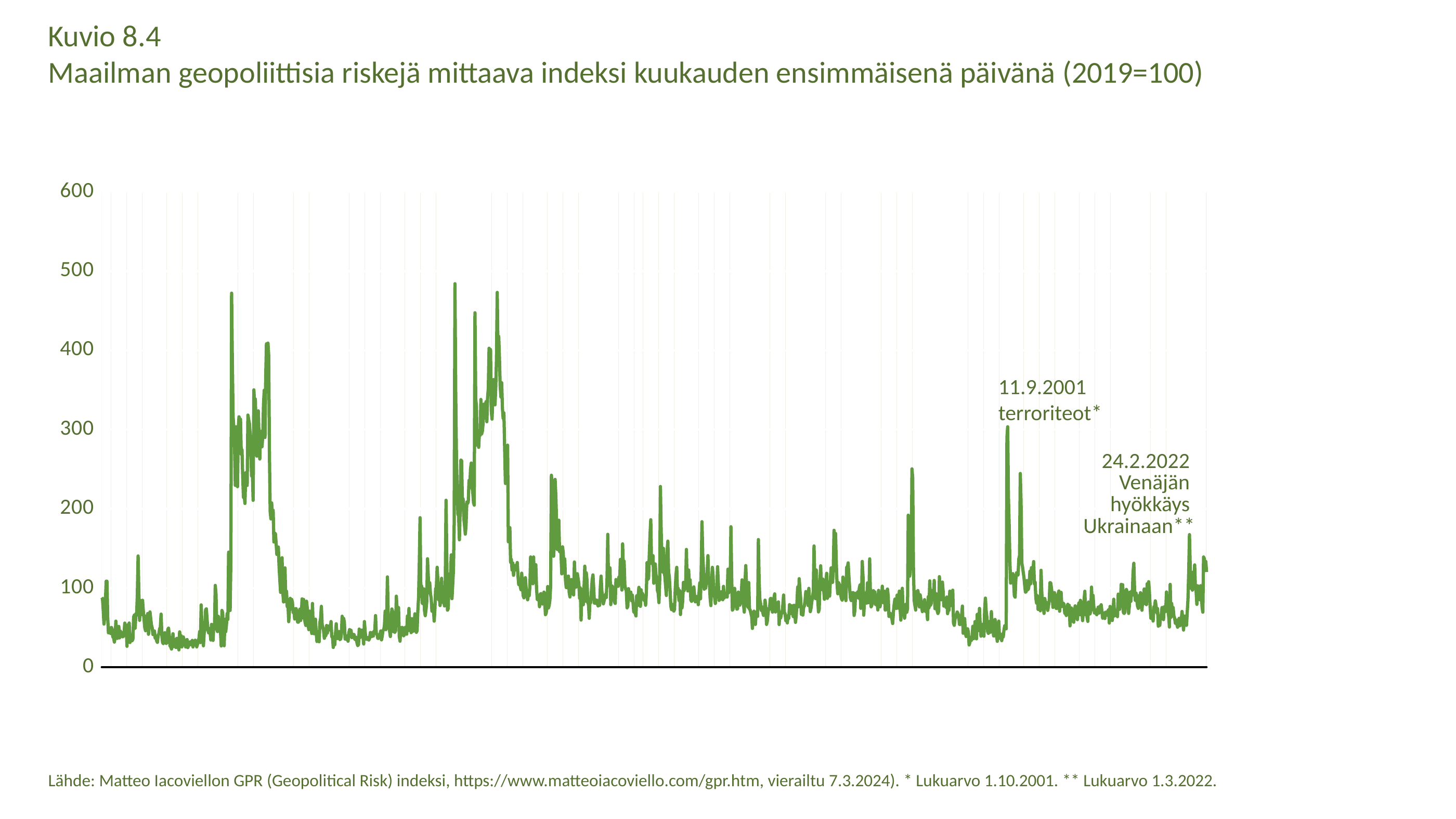
What is the highest value shown on the y axis? 600 Does the line ever rise above 400 on the y axis? yes What kind of chart is shown on the slide? line chart How many annotated events are marked on the chart? 2 What base year is the index set to 100, according to the chart title? 2019 Is the value of the index at the point annotated "24.2.2022 Venäjän hyökkäys Ukrainaan**" greater or less than 200? less What is the title of the chart? Maailman geopoliittisia riskejä mittaava indeksi kuukauden ensimmäisenä päivänä (2019=100) Is the value of the index at the point annotated "24.2.2022 Venäjän hyökkäys Ukrainaan**" greater or less than 100? greater Which annotated event has the higher index value: 11.9.2001 terroriteot or 24.2.2022 Venäjän hyökkäys Ukrainaan? 11.9.2001 terroriteot